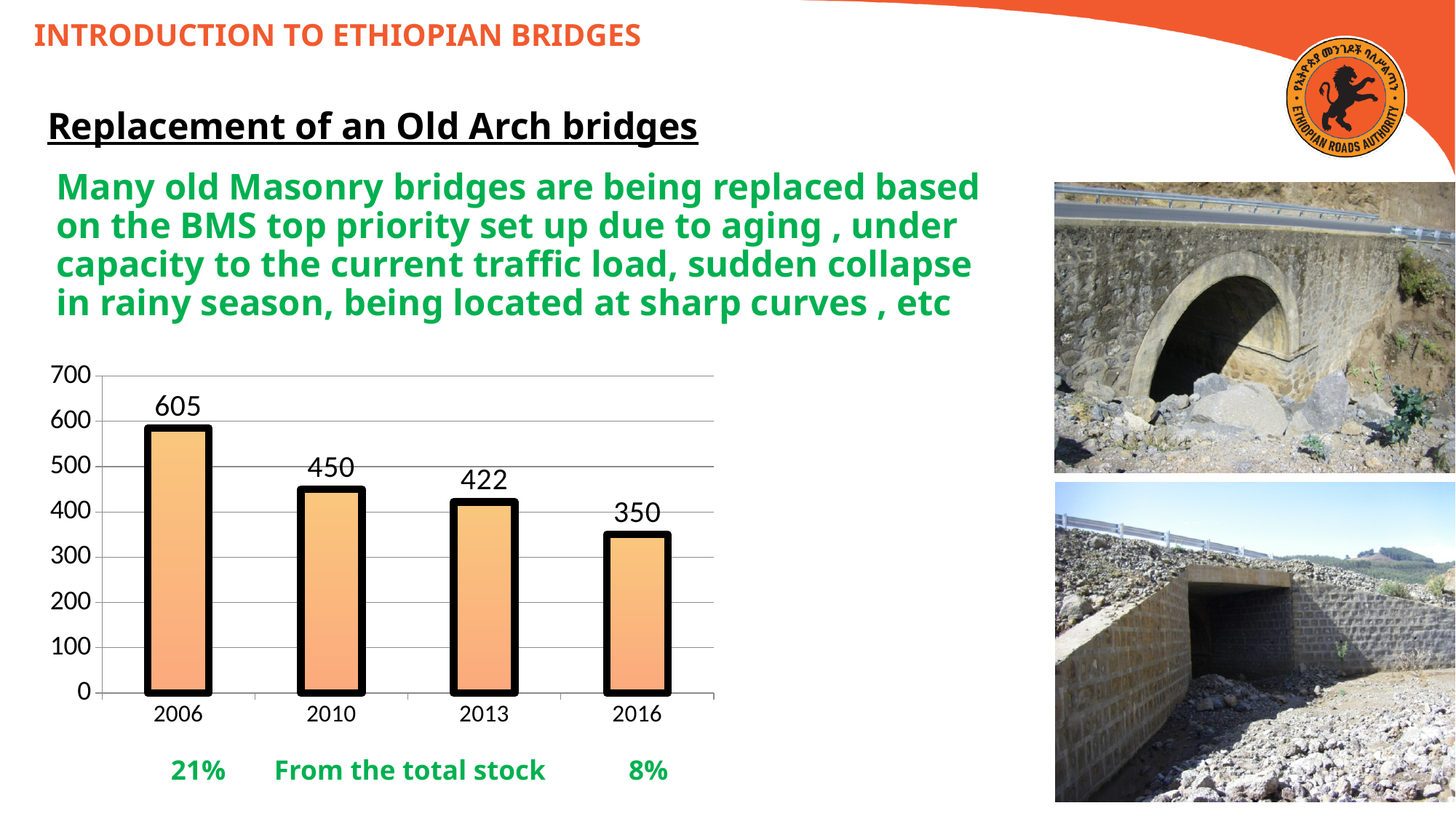
How many years are shown on the x axis? 4 What is the value for 2006? 605 Which year has the highest value? 2006 What is the value for 2016? 350 What is the value for 2010? 450 Which year has the lowest value? 2016 What kind of chart is shown? Bar chart What is the difference between the values for 2006 and 2016? 255 Do the values rise or fall from 2006 to 2016? Fall What is the value for 2013? 422 What is the difference between the values for 2010 and 2013? 28 Which is larger, the value for 2010 or the value for 2016? 2010